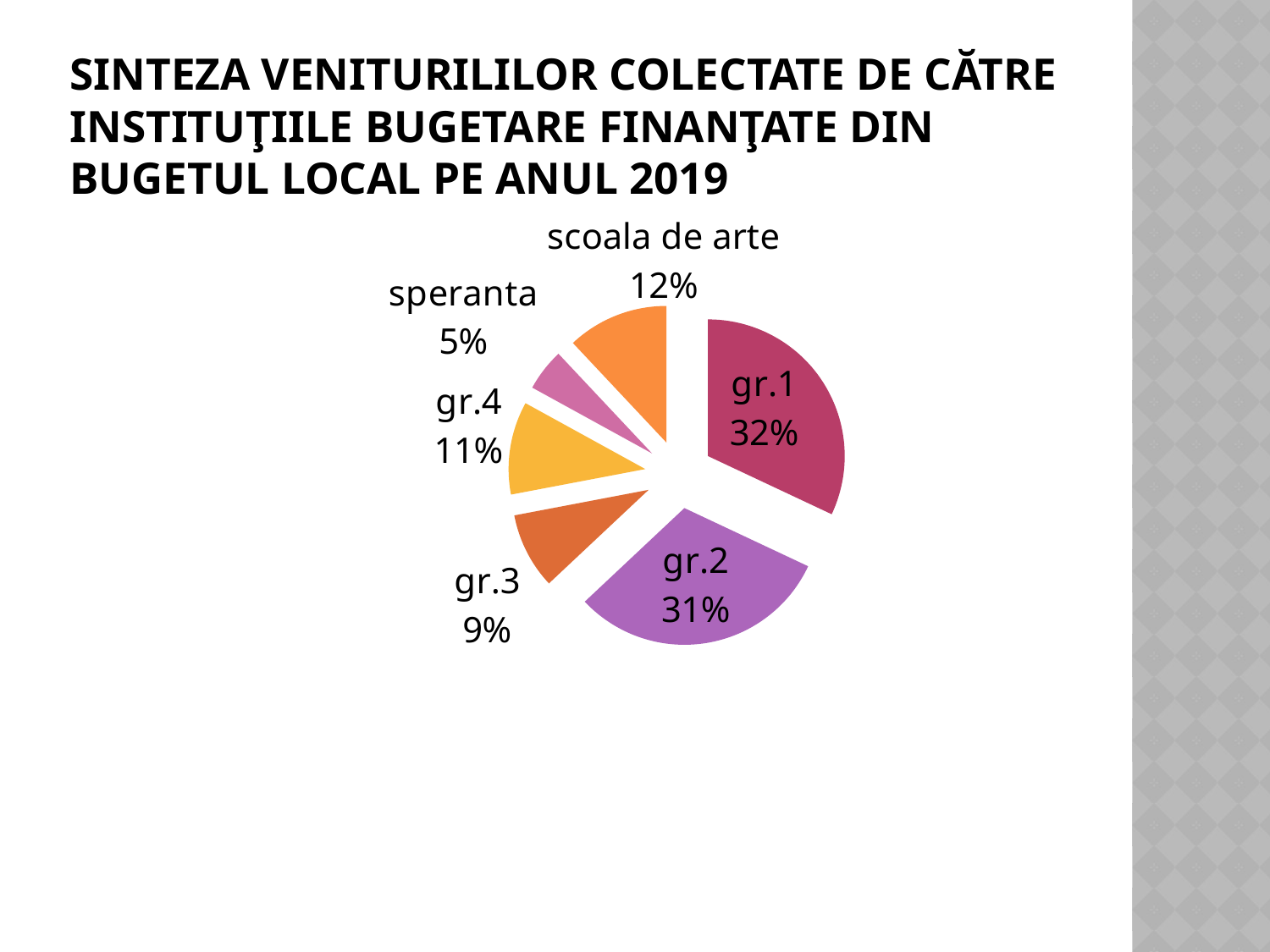
What is the value shown for speranta? 5% Which is larger, the slice for gr.4 or the slice for speranta? gr.4 What share of the pie does gr.1 have? 32% How many slices does the pie chart have? 6 What is the difference in percentage points between gr.1 and gr.3? 23 What kind of chart is shown on the slide? pie chart Which category has the smallest slice of the pie? speranta What is the value shown for gr.3? 9% What is the value shown for gr.4? 11% What is the difference in percentage points between scoala de arte and gr.4? 1 What share of the pie does gr.2 have? 31% What is the value shown for scoala de arte? 12%